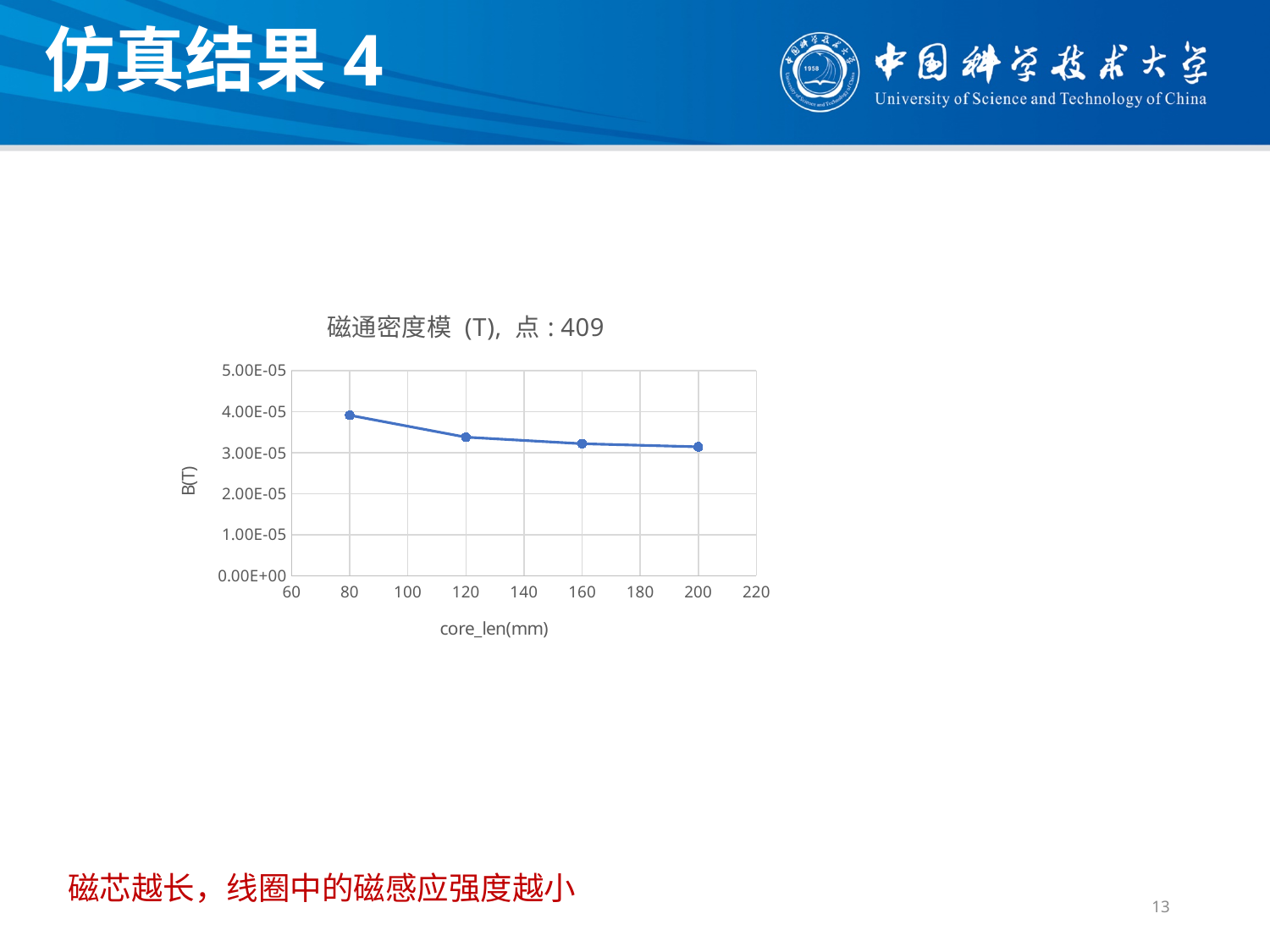
Is the value of B(T) at core_len 120 greater or less than 4.00E-05? less Is the value of B(T) at core_len 80 greater or less than 3.00E-05? greater Is the value of B(T) at core_len 200 greater or less than 4.00E-05? less What is the title of the chart? 磁通密度模 (T), 点: 409 Does the value of B(T) rise or fall as core_len increases along the x axis? fall At which core_len value is B(T) highest? 80 How many data points are plotted on the chart? 4 Which has a larger B(T) value: core_len 80 or core_len 200? core_len 80 What is the label of the x axis of the chart? core_len(mm) What kind of chart is shown on the slide? line chart